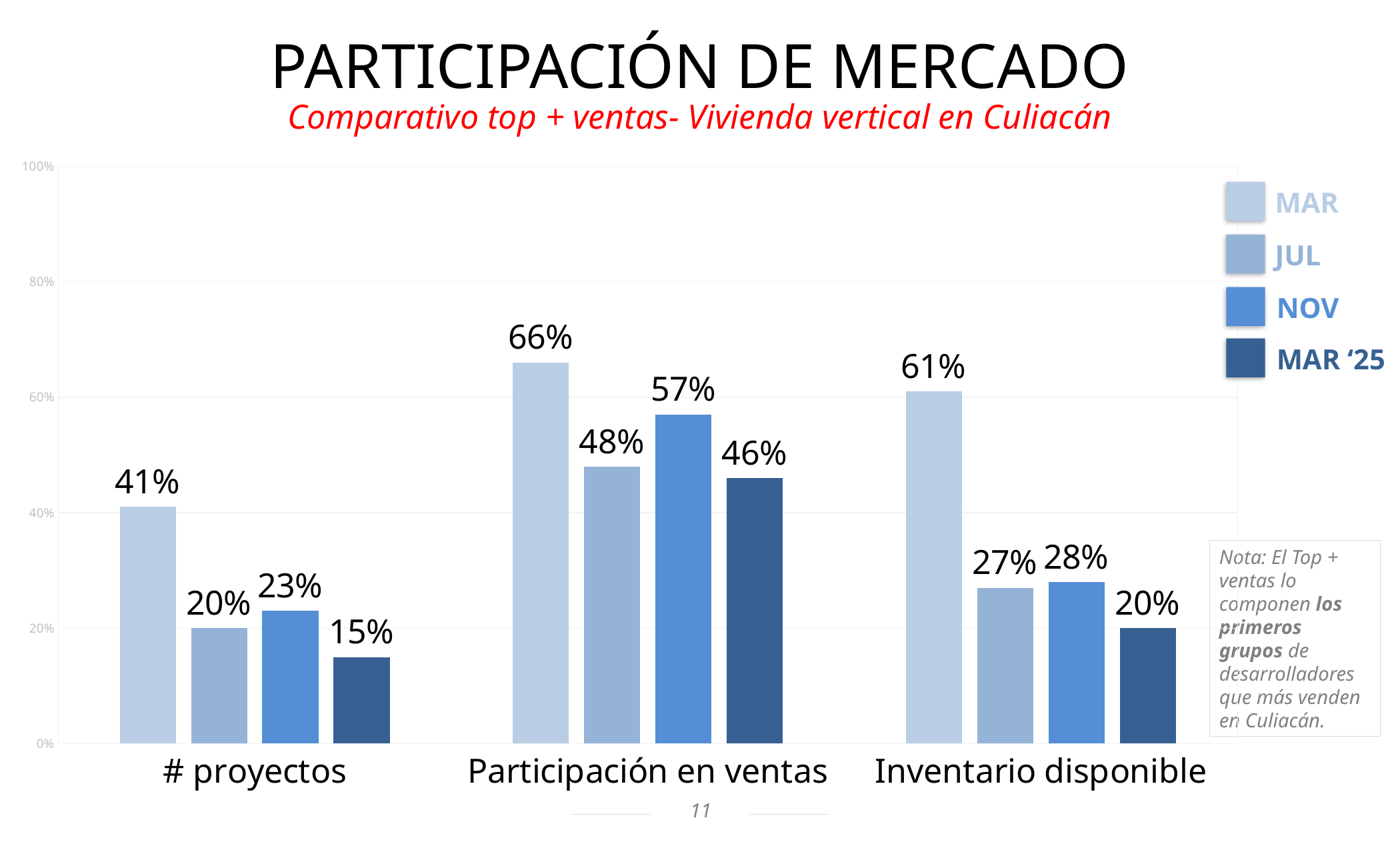
Which series has the lowest value for # proyectos? MAR '25 What is the MAR '25 value for Inventario disponible? 20% What is the difference between the MAR and MAR '25 values for Inventario disponible? 41% Which is larger for Participación en ventas: the JUL value or the MAR '25 value? JUL What is the JUL value for Inventario disponible? 27% How many series does the legend list? 4 What is the MAR value for # proyectos? 41% Which series has the highest value for Participación en ventas? MAR What is the NOV value for Participación en ventas? 57% What is the red subtitle of the chart? Comparativo top + ventas- Vivienda vertical en Culiacán How many categories are shown on the x axis? 3 What kind of chart is shown on the slide? Bar chart